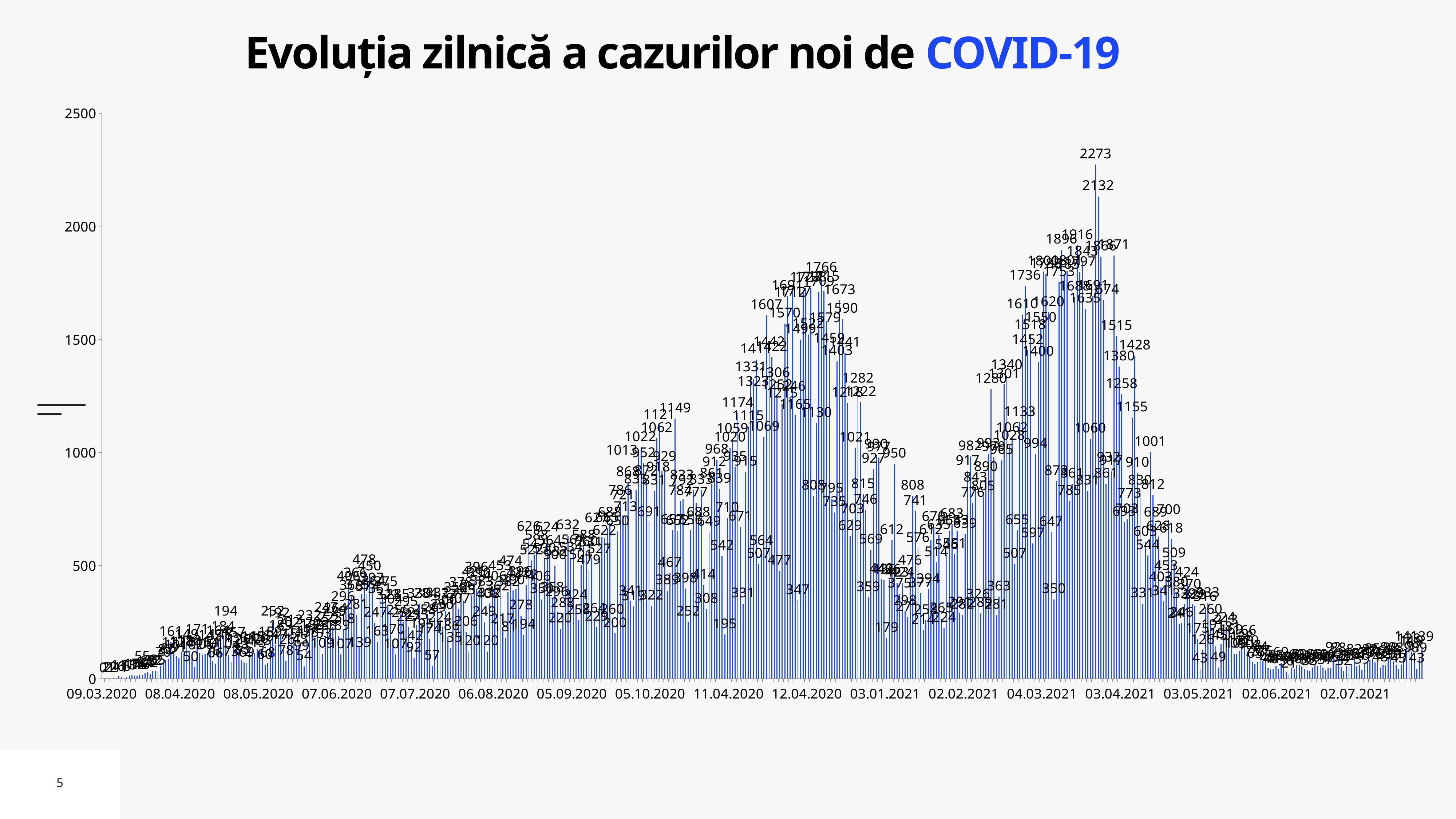
What is the first date label on the x axis? 09.03.2020 Are the bars around 02.06.2021 greater or less than 500? less Do the values rise or fall between 09.03.2020 and 08.04.2020? rise What kind of chart is shown on the slide? bar chart Is the tallest bar on the chart greater or less than 2000? greater What is the difference between the two highest labelled values, 2273 and 2132? 141 What is the title of the chart? Evoluția zilnică a cazurilor noi de COVID-19 Is the peak labelled 1766 greater or less than 1500? greater Do the values rise or fall between 03.04.2021 and 03.05.2021? fall What is the highest daily value shown on the chart? 2273 Which is larger, the peak labelled 2273 or the peak labelled 1766? 2273 What is the second-highest labelled value, printed just below the 2273 peak? 2132